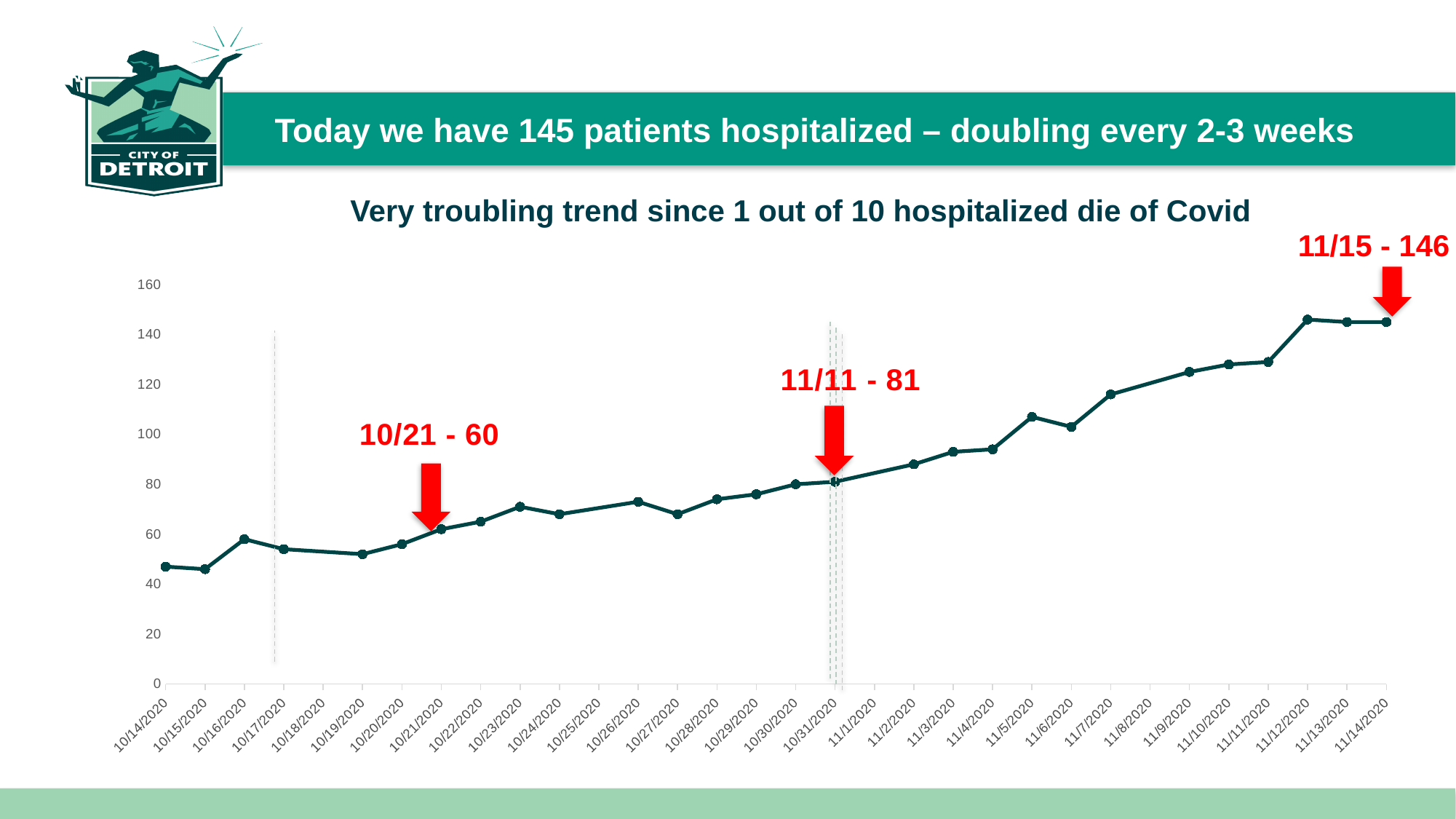
Which has the larger value, 11/5/2020 or 11/6/2020? 11/5/2020 How many dates are plotted along the x axis of the chart? 32 Is the value for 10/14/2020 greater or less than 60? less What kind of chart is shown on the slide? line chart Is the value for 11/14/2020 greater or less than 140? greater Is the value for 11/5/2020 greater or less than 100? greater Do the values generally rise or fall from 10/14/2020 to 11/14/2020? rise What value does the red annotation at the far right of the chart give for 11/15? 146 What is the title of the chart? Very troubling trend since 1 out of 10 hospitalized die of Covid